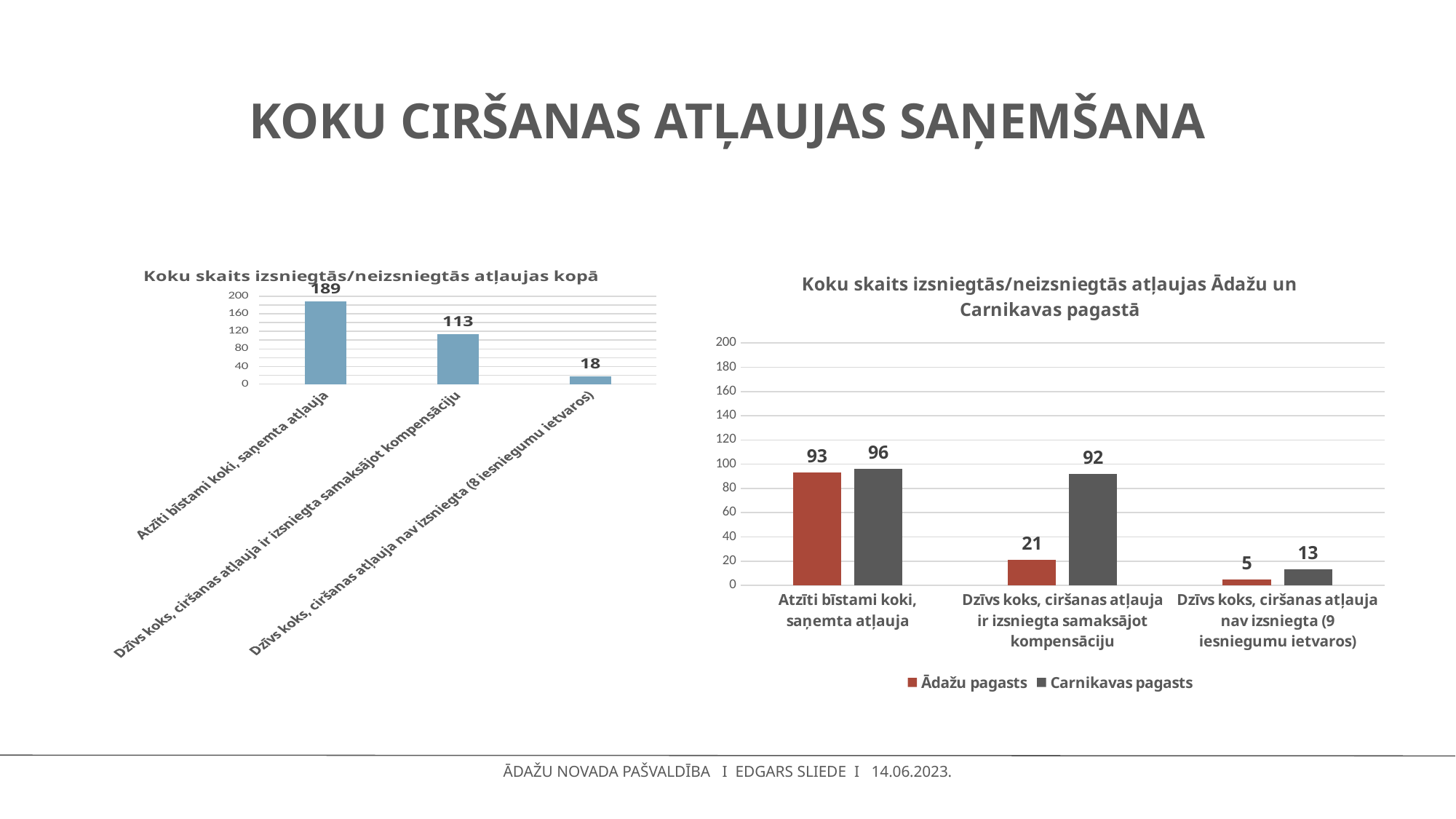
How many series does the legend of the right chart 'Koku skaits izsniegtās/neizsniegtās atļaujas Ādažu un Carnikavas pagastā' list? 2 In the right chart 'Koku skaits izsniegtās/neizsniegtās atļaujas Ādažu un Carnikavas pagastā', what is the value for Carnikavas pagasts in 'Atzīti bīstami koki, saņemta atļauja'? 96 In the left chart 'Koku skaits izsniegtās/neizsniegtās atļaujas kopā', which category has the lowest value? Dzīvs koks, ciršanas atļauja nav izsniegta (8 iesniegumu ietvaros) In the left chart 'Koku skaits izsniegtās/neizsniegtās atļaujas kopā', what is the difference between the values for 'Atzīti bīstami koki, saņemta atļauja' and 'Dzīvs koks, ciršanas atļauja ir izsniegta samaksājot kompensāciju'? 76 In the left chart 'Koku skaits izsniegtās/neizsniegtās atļaujas kopā', what is the value for 'Dzīvs koks, ciršanas atļauja ir izsniegta samaksājot kompensāciju'? 113 In the right chart 'Koku skaits izsniegtās/neizsniegtās atļaujas Ādažu un Carnikavas pagastā', what is the value for Ādažu pagasts in 'Dzīvs koks, ciršanas atļauja ir izsniegta samaksājot kompensāciju'? 21 In the right chart 'Koku skaits izsniegtās/neizsniegtās atļaujas Ādažu un Carnikavas pagastā', which is larger for 'Dzīvs koks, ciršanas atļauja nav izsniegta (9 iesniegumu ietvaros)': Ādažu pagasts or Carnikavas pagasts? Carnikavas pagasts In the right chart 'Koku skaits izsniegtās/neizsniegtās atļaujas Ādažu un Carnikavas pagastā', which colour represents Ādažu pagasts? Red In the right chart 'Koku skaits izsniegtās/neizsniegtās atļaujas Ādažu un Carnikavas pagastā', what is the difference between Carnikavas pagasts and Ādažu pagasts for 'Dzīvs koks, ciršanas atļauja ir izsniegta samaksājot kompensāciju'? 71 How many categories does the left chart 'Koku skaits izsniegtās/neizsniegtās atļaujas kopā' show? 3 In the left chart 'Koku skaits izsniegtās/neizsniegtās atļaujas kopā', what is the value for 'Atzīti bīstami koki, saņemta atļauja'? 189 What type of chart is the right chart 'Koku skaits izsniegtās/neizsniegtās atļaujas Ādažu un Carnikavas pagastā'? Bar chart